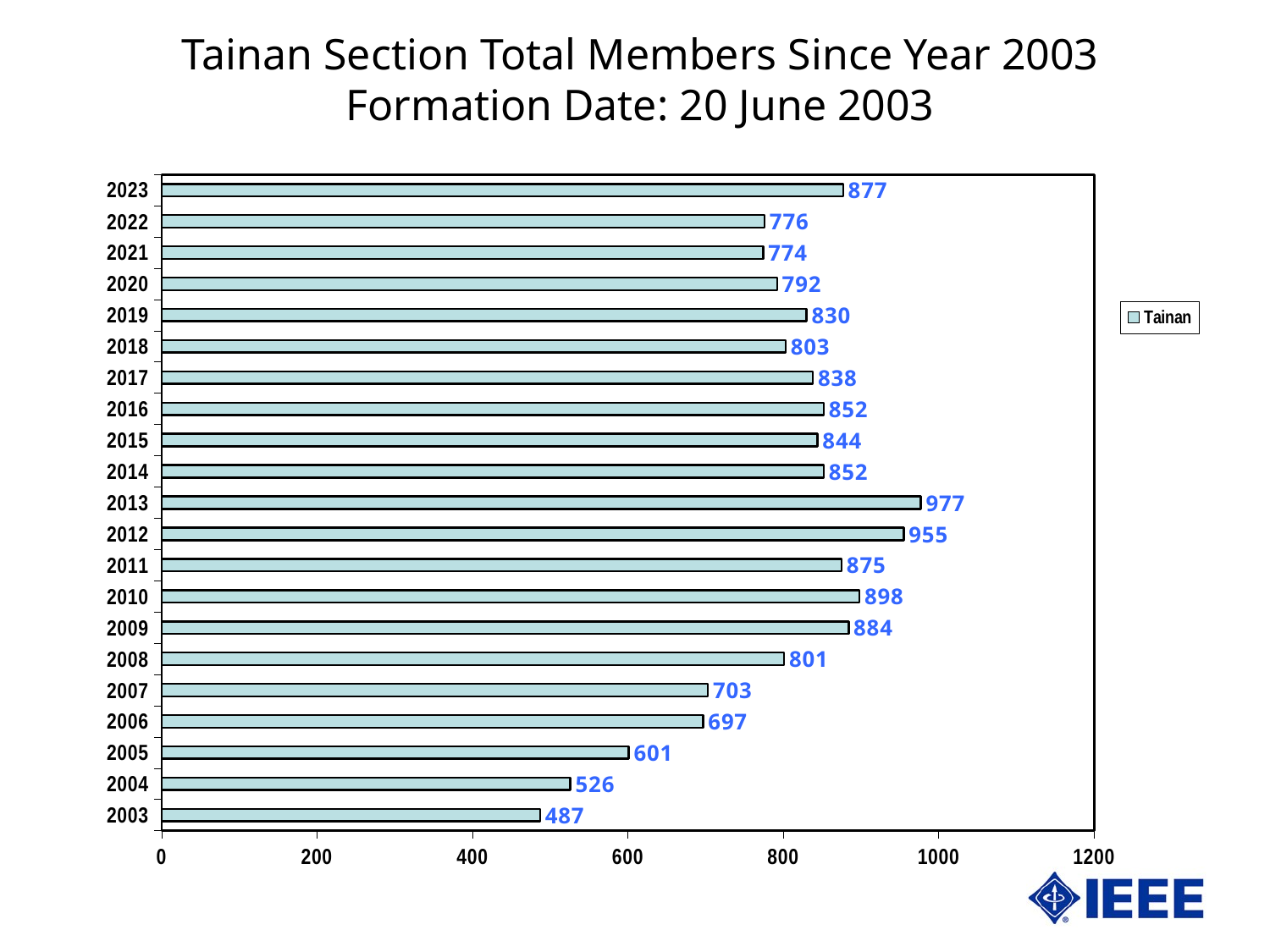
How many series does the legend list? 1 What series name is shown in the legend? Tainan What is the value for 2003? 487 What is the value for 2023? 877 Which year has the lowest value? 2003 What is the value for 2013? 977 How many years are shown on the chart? 21 Which year has the highest value? 2013 Is the value for 2005 greater or less than 800? less What is the difference between the values for 2023 and 2022? 101 What kind of chart is shown? bar chart Which is larger, the value for 2012 or the value for 2010? 2012